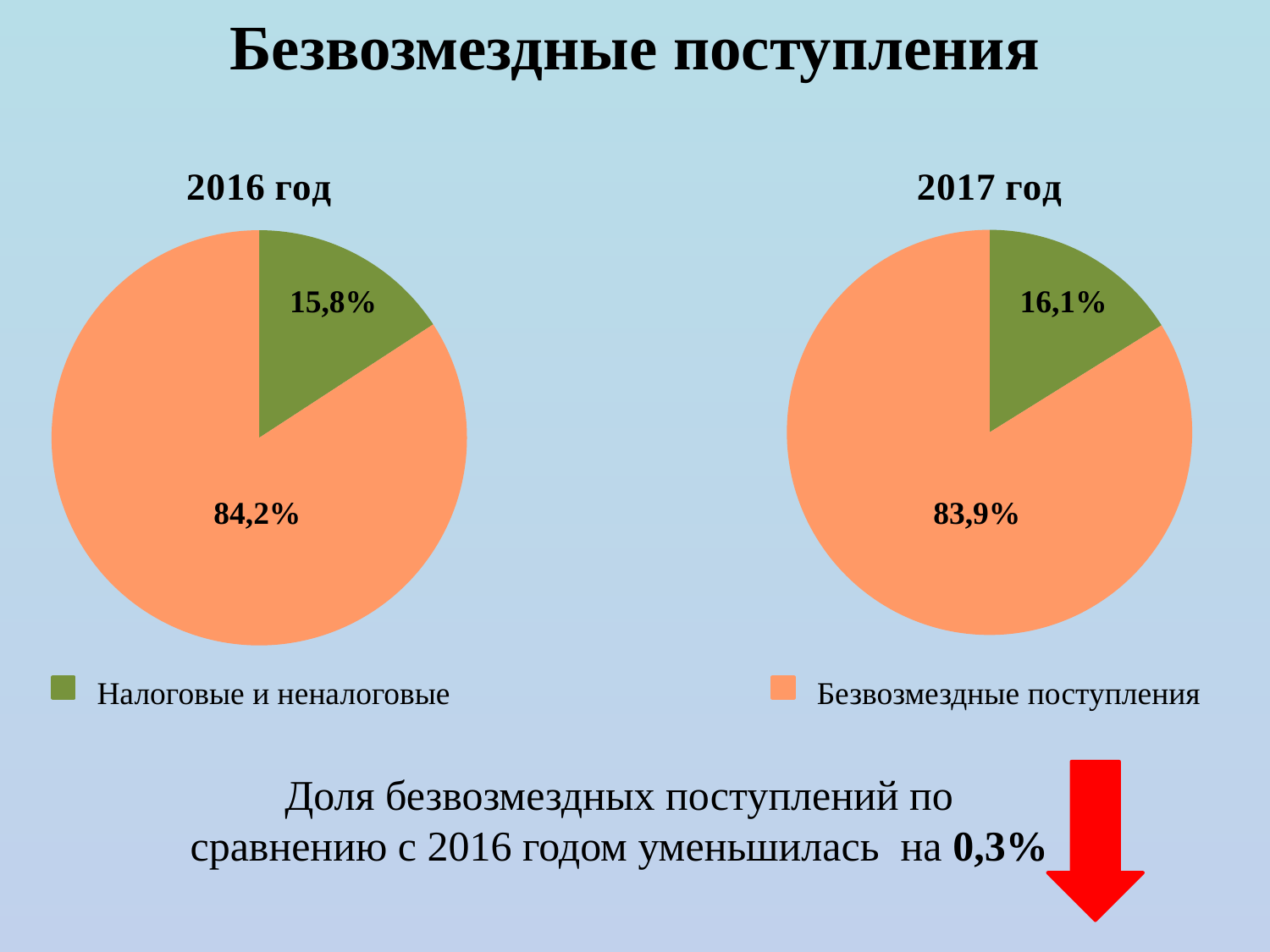
What type of chart is used for the 2016 год data? Pie chart What is the difference between the Безвозмездные поступления share in the 2016 год chart and in the 2017 год chart? 0,3% In the 2017 год pie chart, which category has the smallest slice? Налоговые и неналоговые In the 2017 год pie chart, what share is labelled for Безвозмездные поступления? 83,9% How many categories does the legend list? 2 Which is larger: the Налоговые и неналоговые share in the 2016 год chart or in the 2017 год chart? 2017 год In the 2017 год pie chart, what share is labelled for Налоговые и неналоговые? 16,1% In the 2016 год pie chart, which category has the largest slice? Безвозмездные поступления In the 2016 год pie chart, what share is labelled for Налоговые и неналоговые? 15,8% How many slices does the 2017 год pie chart have? 2 What colour represents Налоговые и неналоговые in the pie charts? Green In the 2016 год pie chart, what share is labelled for Безвозмездные поступления? 84,2%